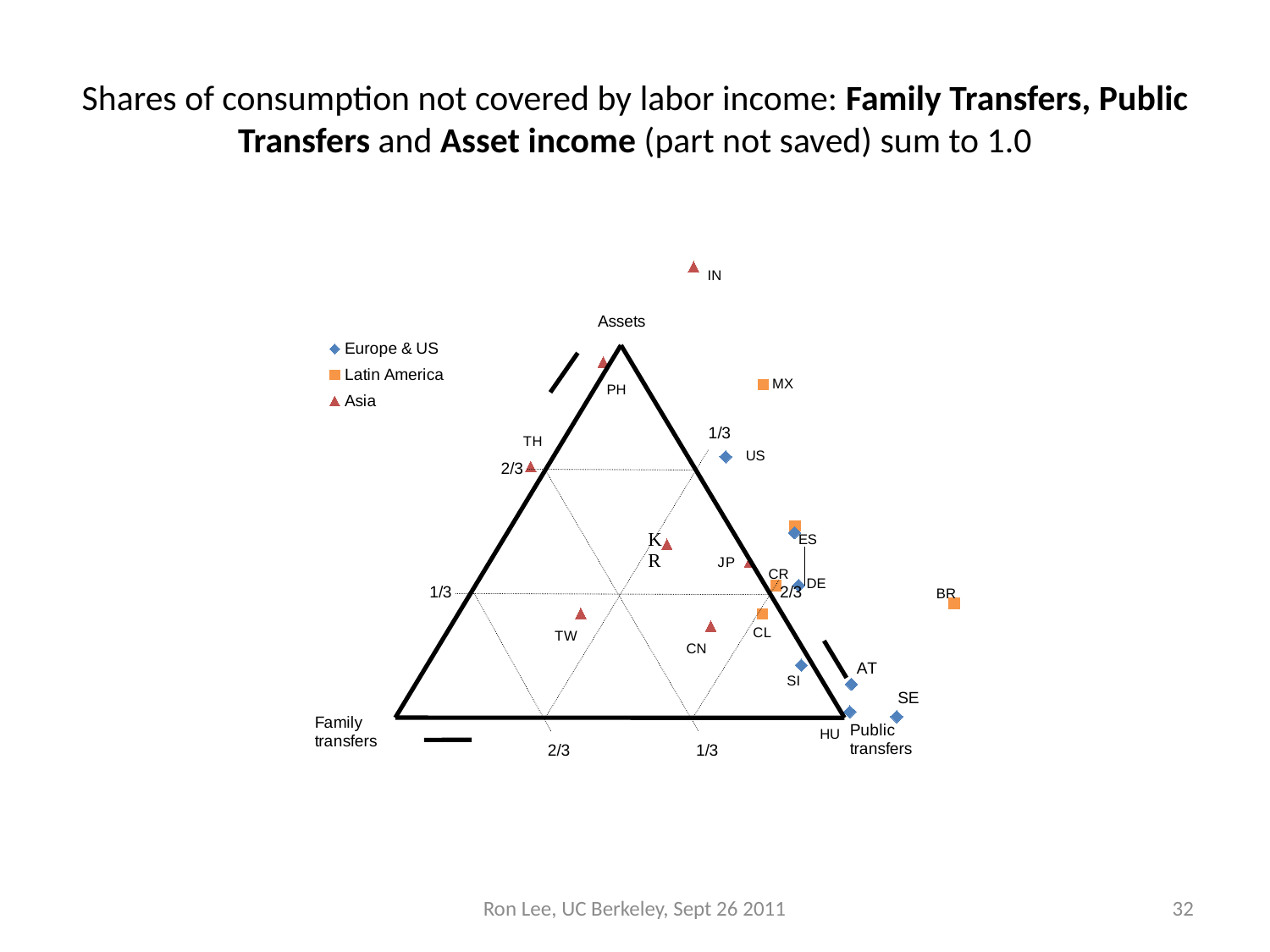
Which has a higher assets share, US or HU? US Which country has the highest assets share? IN Which has a higher public transfers share, BR or TH? BR What kind of chart is shown on the slide? Ternary scatter plot What are the labels at the three corners of the triangle? Assets, Family transfers, Public transfers Which country has the highest public transfers share? BR Which has a higher assets share, PH or CN? PH How many series does the legend list? 3 Which country has the lowest assets share? SE How many Asia (triangle) points are plotted? 7 What are the three series listed in the legend? Europe & US, Latin America, Asia